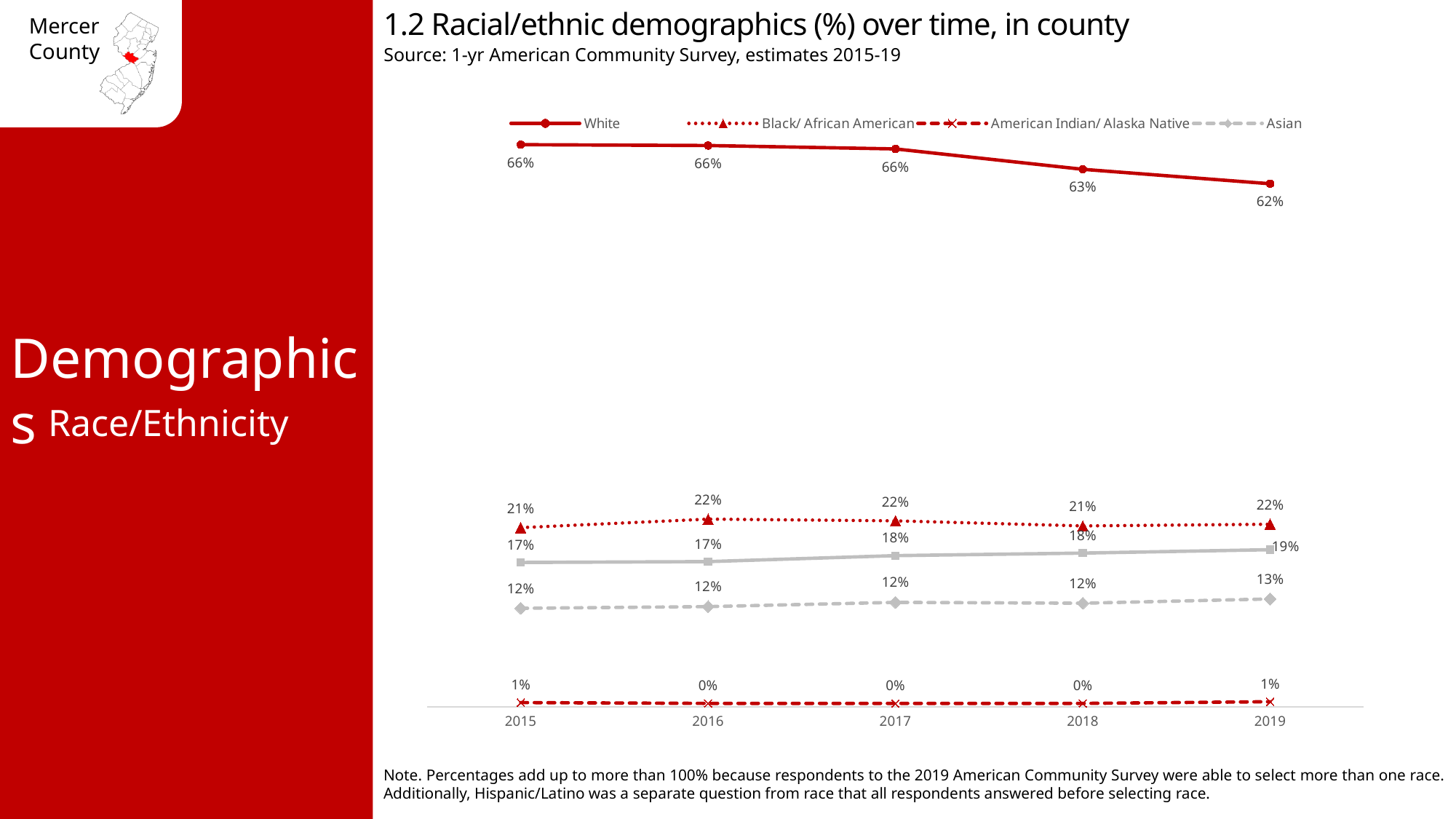
What type of chart is shown on the slide? line chart What is the source of the data shown in the chart? 1-yr American Community Survey, estimates 2015-19 Which was larger in 2018, the Black/ African American percentage or the Asian percentage? Black/ African American Does the White percentage rise or fall from 2015 to 2019? fall What is the difference between the White and Black/ African American percentages in 2019? 40 What was the White percentage in 2019? 62% What was the Asian percentage in 2019? 13% How many years are shown on the x axis? 5 What was the Black/ African American percentage in 2016? 22% What was the American Indian/ Alaska Native percentage in 2017? 0% In which year was the White percentage lowest? 2019 By how many percentage points did the White percentage change from 2015 to 2019? 4